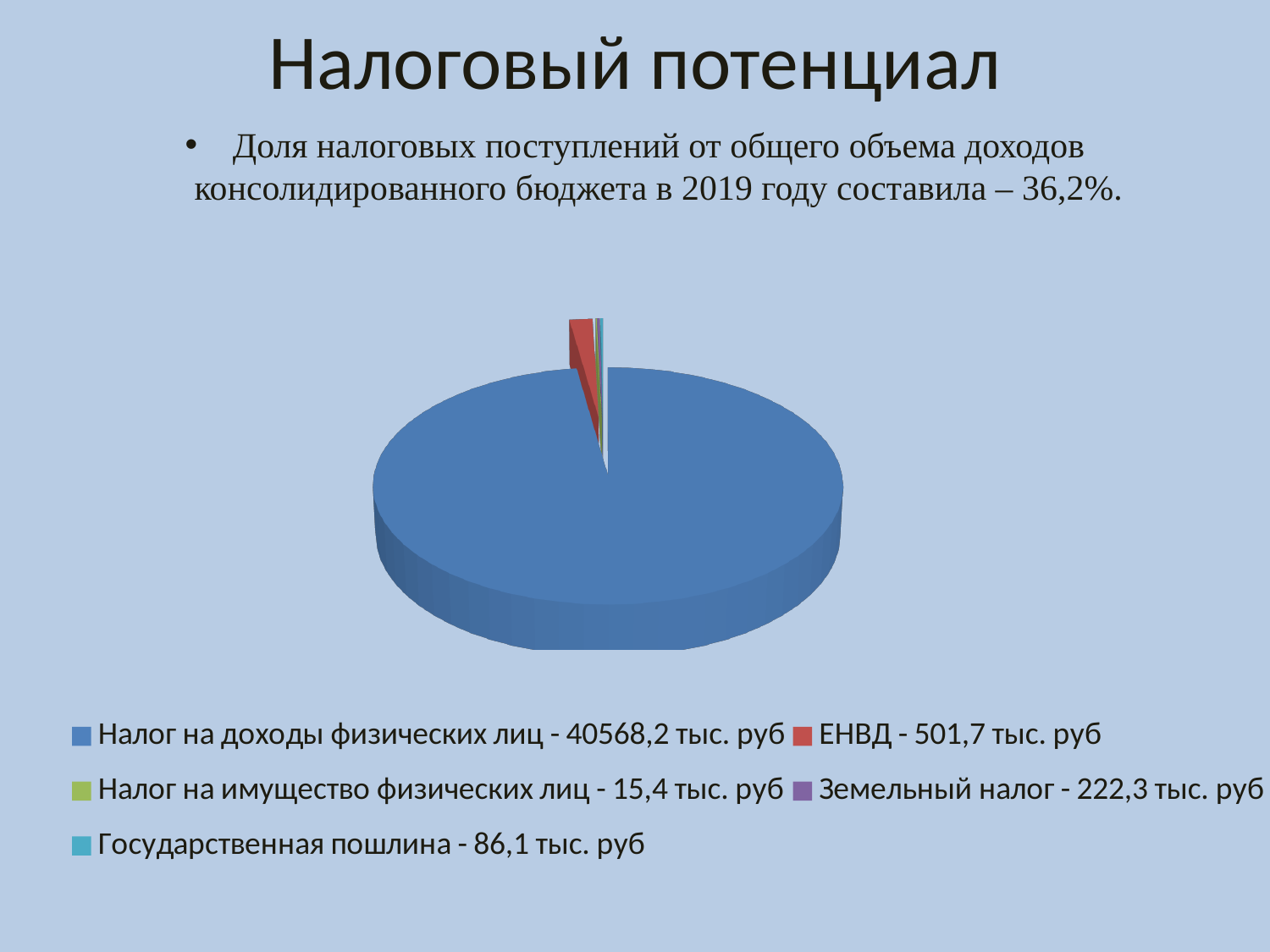
What is the value for Налог на доходы физических лиц? 40568,2 тыс. руб What is the value for Государственная пошлина? 86,1 тыс. руб What is the value for ЕНВД? 501,7 тыс. руб What kind of chart is shown on the slide? Pie chart What colour is the slice for Налог на доходы физических лиц? Blue Which is larger, ЕНВД or Земельный налог? ЕНВД What is the value for Налог на имущество физических лиц? 15,4 тыс. руб Which category has the smallest value? Налог на имущество физических лиц Which category has the largest value? Налог на доходы физических лиц What is the difference between ЕНВД and Земельный налог? 279,4 тыс. руб How many categories does the pie chart have? 5 What is the value for Земельный налог? 222,3 тыс. руб